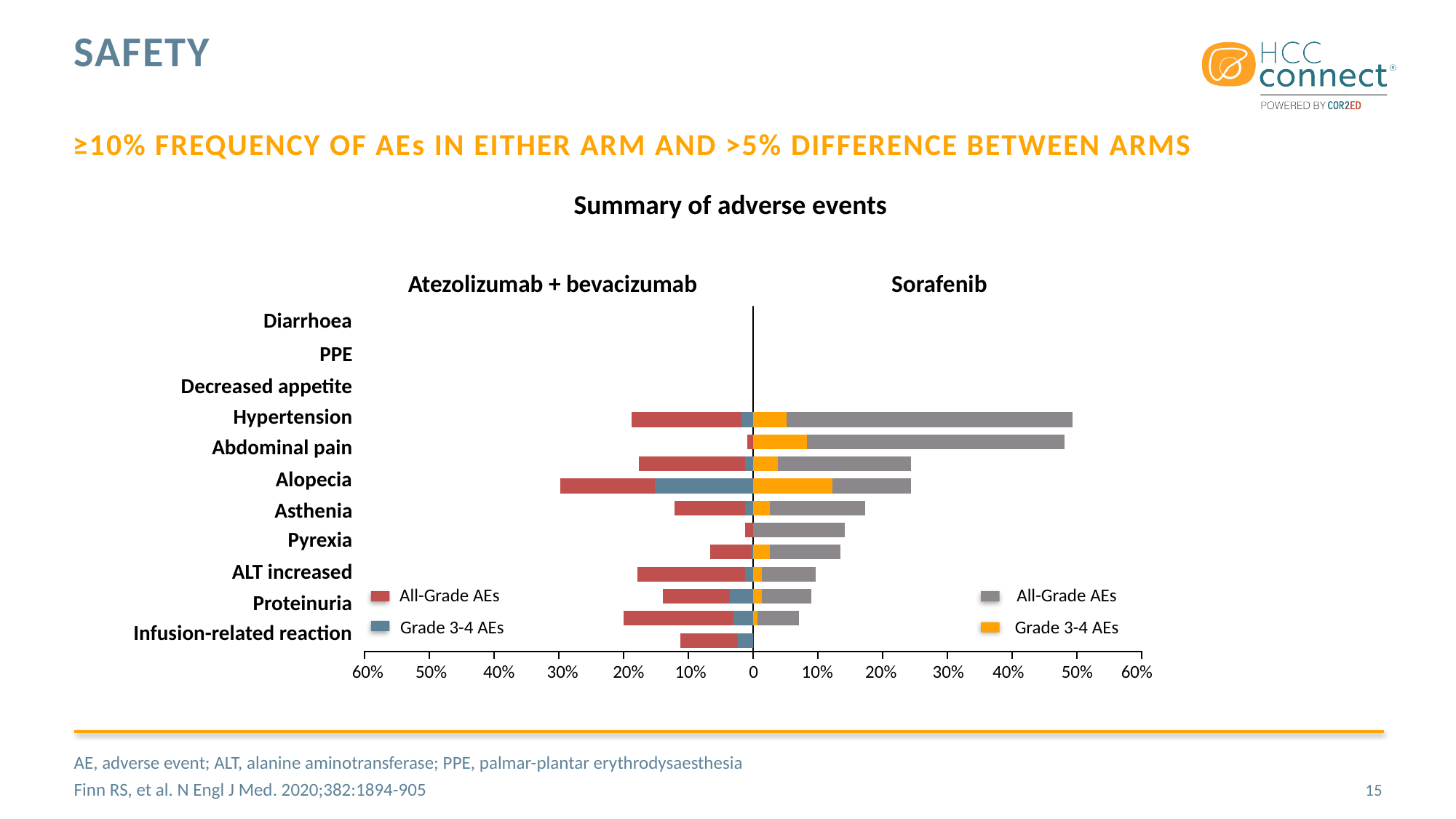
How many entries does the legend for the Sorafenib arm list? 2 Is the longest All-Grade AEs bar in the Atezolizumab + bevacizumab arm greater or less than 40%? less Which two treatment arms are compared in the chart? Atezolizumab + bevacizumab and Sorafenib Which arm has the single longest All-Grade AEs bar in the chart? Sorafenib What is the title of the chart? Summary of adverse events What kind of chart is shown on the slide? Bar chart Is the longest All-Grade AEs bar in the Sorafenib arm greater or less than 40%? greater What is the highest value shown on the horizontal axis of the chart? 60% Is the longest All-Grade AEs bar in the Atezolizumab + bevacizumab arm greater or less than 20%? greater How many adverse event categories are labelled on the vertical axis of the chart? 11